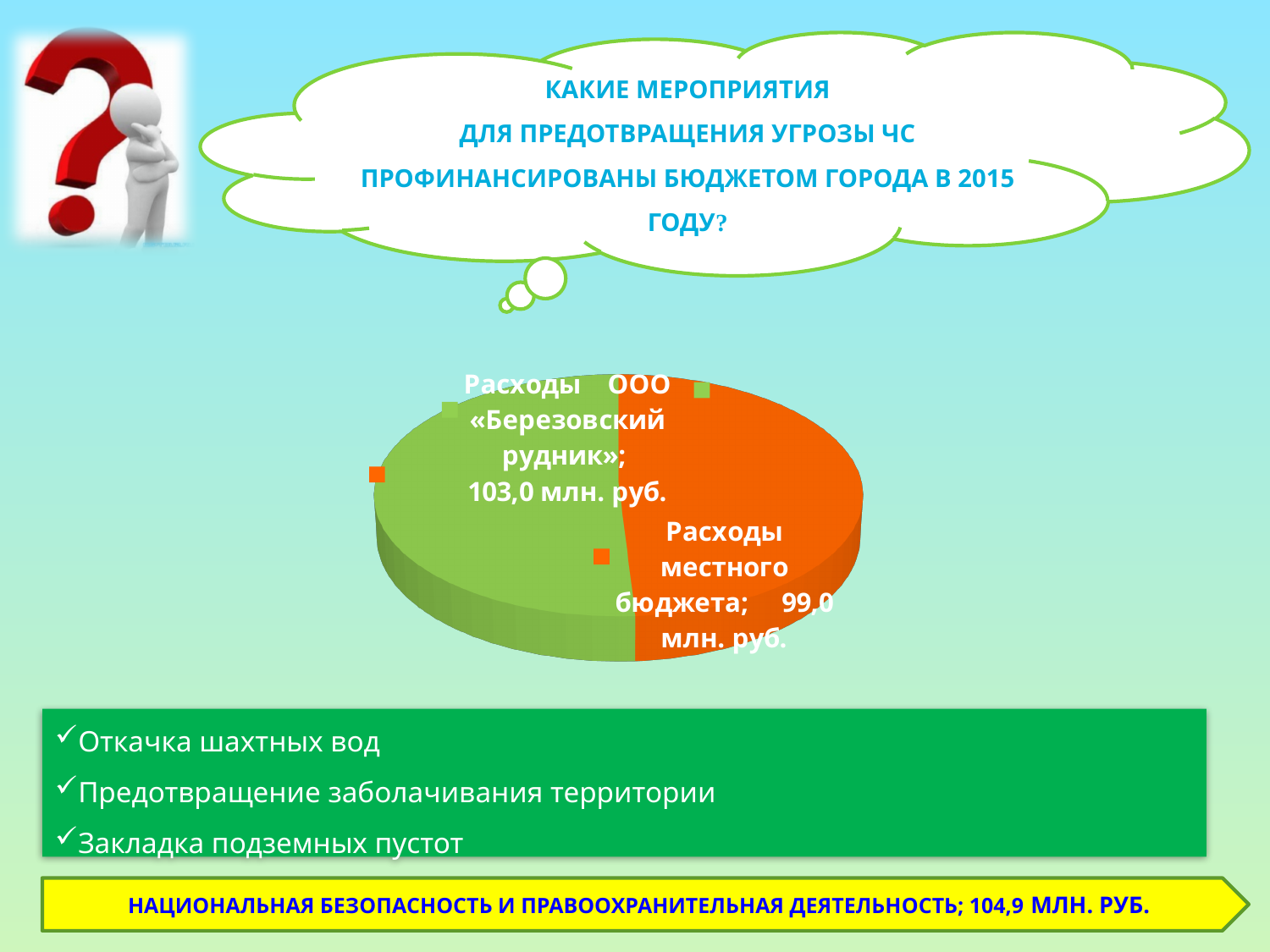
What is the value for «Расходы ООО «Березовский рудник»» in the pie chart? 103,0 млн. руб. How many slices does the pie chart have? 2 Which is larger in the pie chart: «Расходы ООО «Березовский рудник»» or «Расходы местного бюджета»? Расходы ООО «Березовский рудник» What colour is the slice for «Расходы местного бюджета» in the pie chart? Orange What colour is the slice for «Расходы ООО «Березовский рудник»» in the pie chart? Green What is the difference between the expenses of ООО «Березовский рудник» and the local budget expenses in the pie chart? 4,0 млн. руб. What is the total of the two slices in the pie chart? 202,0 млн. руб. What is the value for «Расходы местного бюджета» in the pie chart? 99,0 млн. руб. What type of chart is shown on the slide? Pie chart Which slice of the pie chart is the smallest? Расходы местного бюджета Which slice of the pie chart is the largest? Расходы ООО «Березовский рудник»